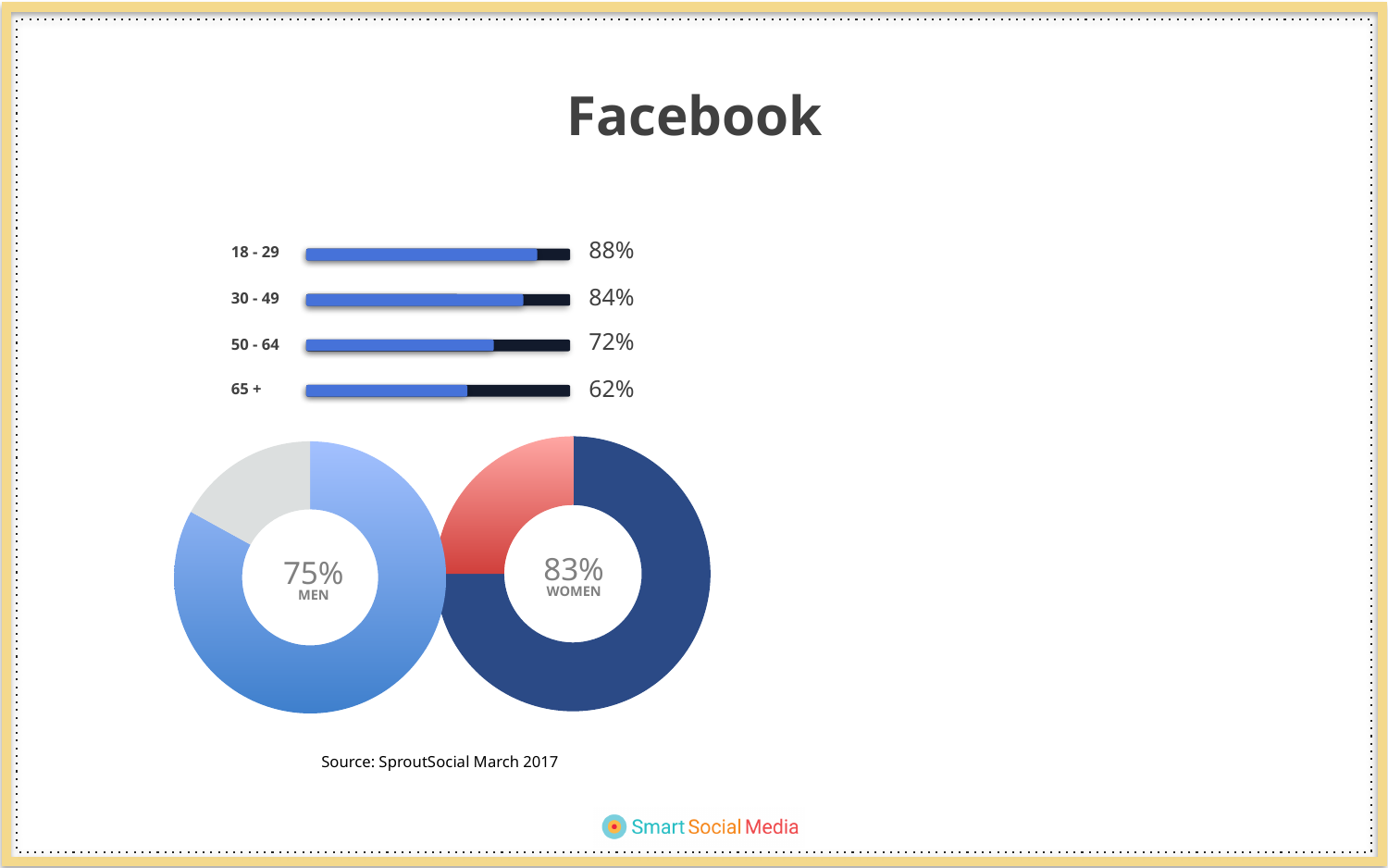
In the bar chart of age groups, what is the value for the 50 - 64 group? 72% In the bar chart of age groups, do the values rise or fall as the age groups get older? fall In the bar chart of age groups, which is larger, the value for 30 - 49 or the value for 50 - 64? 30 - 49 In the bar chart of age groups, which age group has the highest value? 18 - 29 In the bar chart of age groups, what is the value for the 18 - 29 group? 88% In the bar chart of age groups, what is the value for the 65 + group? 62% How many age groups are shown in the bar chart? 4 In the donut chart on the left, what percentage is shown for men? 75% In the bar chart of age groups, what is the difference between the 18 - 29 and 65 + values? 26% What kind of chart shows the age group values? bar chart In the bar chart of age groups, which age group has the lowest value? 65 + Comparing the two donut charts, which is larger, the percentage for men or the percentage for women? women